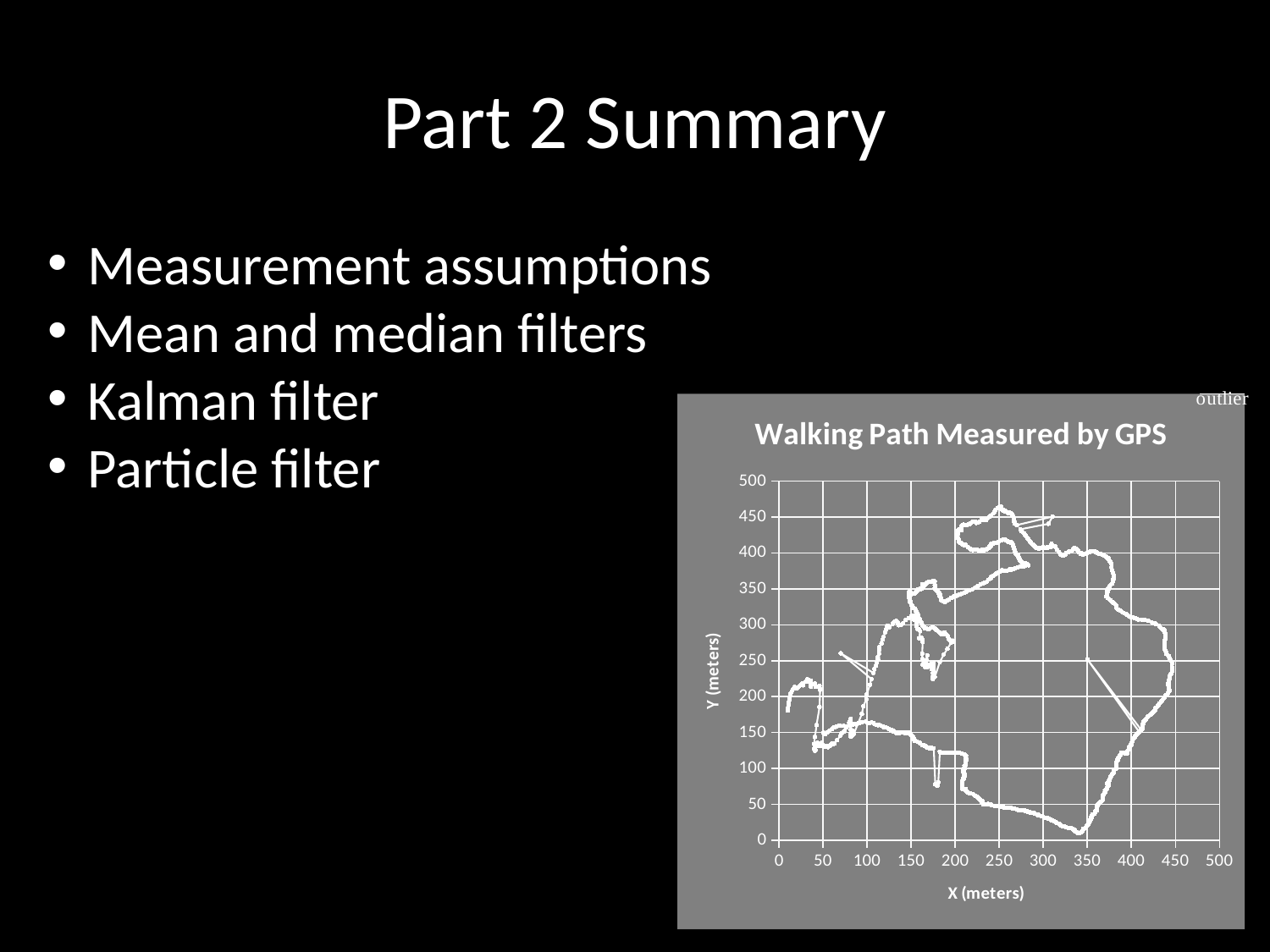
What kind of chart is shown on the slide? scatter (line) chart Is the highest Y value reached by the walking path greater or less than 450? greater Is the smallest X value reached by the walking path greater or less than 50? less Is the lowest Y value reached by the walking path greater or less than 50? less What is the highest tick value shown on the X axis of the chart? 500 What is the label of the vertical axis of the chart? Y (meters) What is the title of the chart on the slide? Walking Path Measured by GPS